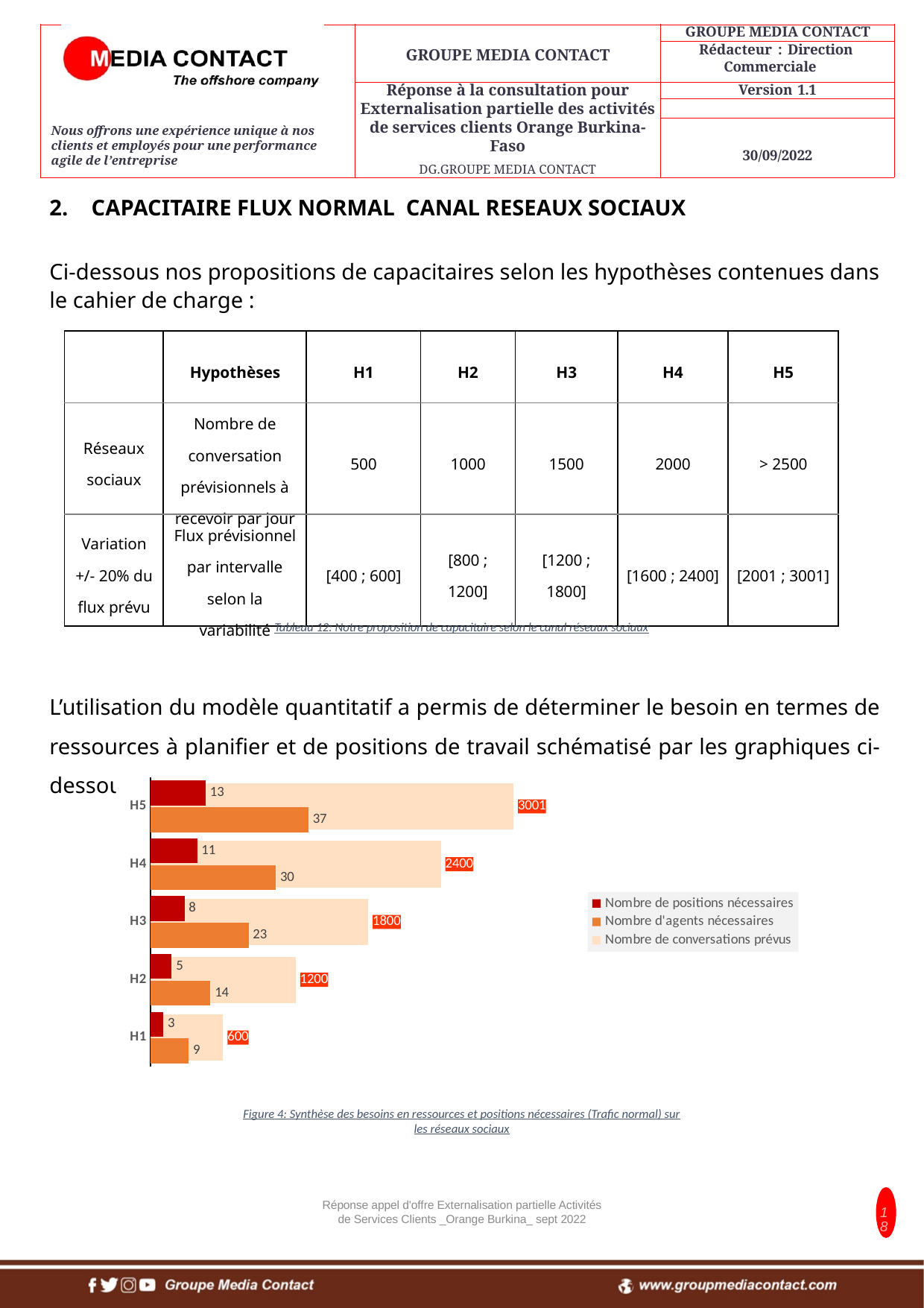
What is the difference in 'Nombre d'agents nécessaires' between H4 and H3? 7 What kind of chart is shown on the slide? bar chart Which series is shown in dark red in the chart legend? Nombre de positions nécessaires Which hypothesis has the lowest 'Nombre d'agents nécessaires'? H1 How many series does the chart legend list? 3 Do the values of 'Nombre de conversations prévus' rise or fall going from H1 to H5? rise Which is larger: 'Nombre de positions nécessaires' for H4 or for H2? H4 What is the value of 'Nombre de conversations prévus' for H2? 1200 What is the value of 'Nombre d'agents nécessaires' for H5? 37 What is the value of 'Nombre de positions nécessaires' for H3? 8 Which hypothesis has the highest 'Nombre de conversations prévus'? H5 How many categories (hypotheses) are plotted on the chart? 5